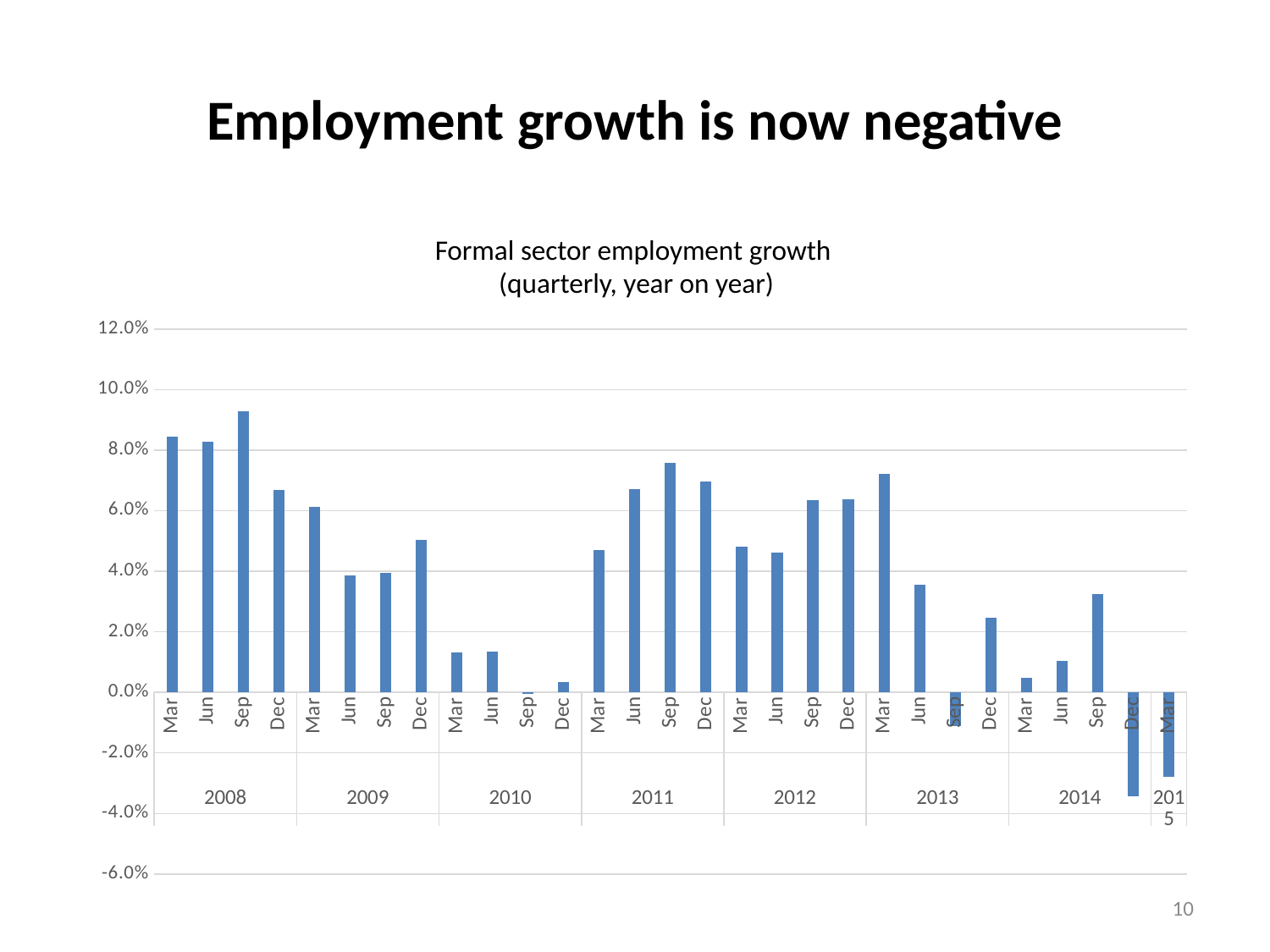
Which is larger, the value for Sep 2008 or the value for Sep 2011? Sep 2008 What is the title of the chart? Formal sector employment growth (quarterly, year on year) Is the value for Mar 2010 greater or less than 2.0%? less Is the value for Sep 2008 greater or less than 8.0%? greater Is the value for Mar 2013 greater or less than 6.0%? greater Overall, do the values rise or fall from 2008 to 2015? Fall Which is larger, the value for Dec 2009 or the value for Dec 2010? Dec 2009 Which quarter has the lowest formal sector employment growth? Dec 2014 What kind of chart is shown on the slide? Bar chart Which quarter has the highest formal sector employment growth? Sep 2008 How many quarterly bars are plotted on the chart? 29